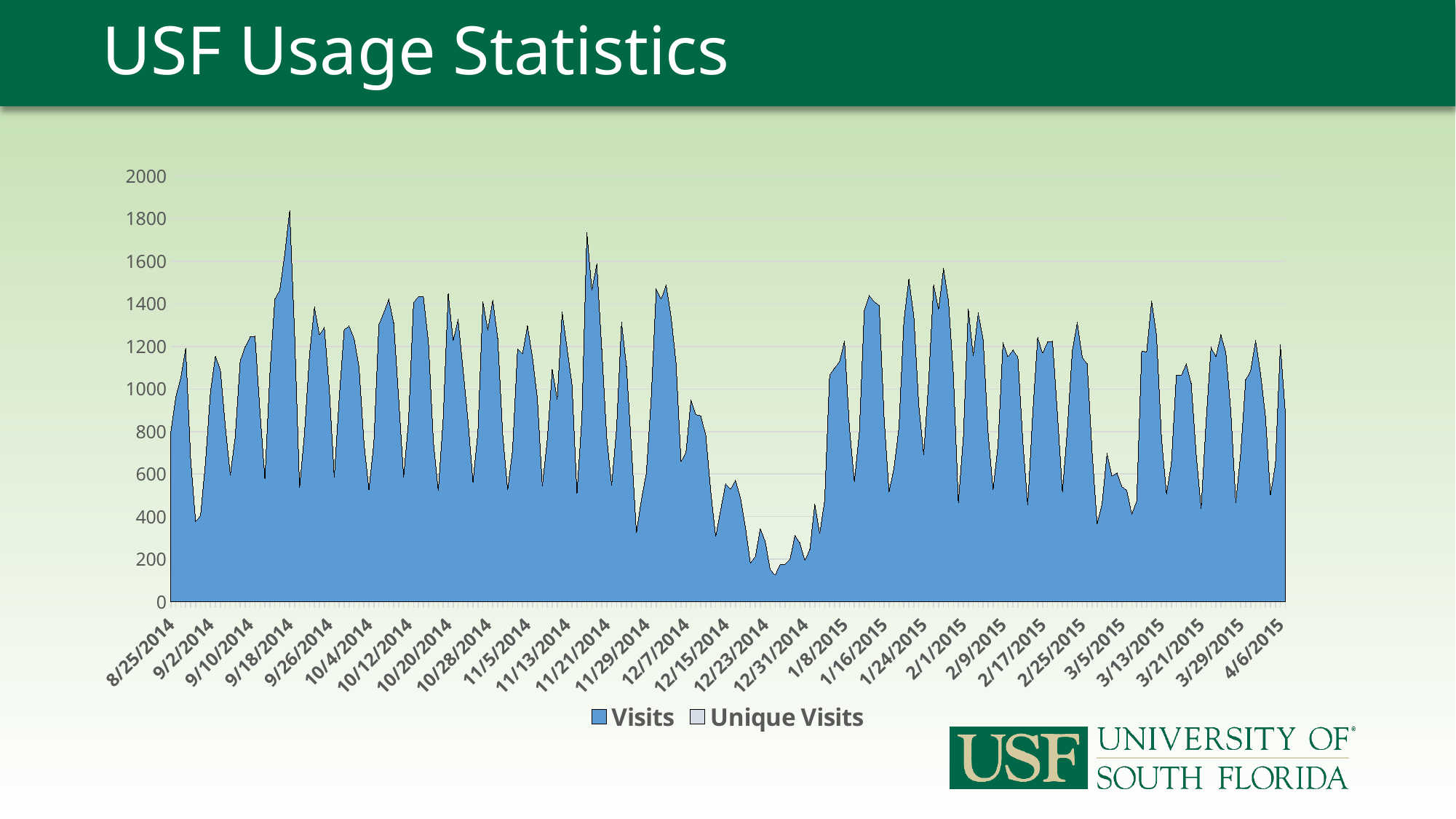
What is the highest value shown on the vertical axis? 2000 Is the peak value near 11/21/2014 greater or less than 1400? greater Is the value at 4/6/2015 greater or less than 800? greater What kind of chart is shown on the slide? Area chart Around which x-axis date does the chart reach its lowest value? 12/23/2014 Around which x-axis date does the chart reach its highest peak? 9/18/2014 Do the values generally rise or fall between 12/7/2014 and 12/23/2014? fall What are the two series named in the legend? Visits and Unique Visits Is the value near 12/23/2014 greater or less than 400? less How many series does the legend list? 2 What is the title of the slide containing the chart? USF Usage Statistics